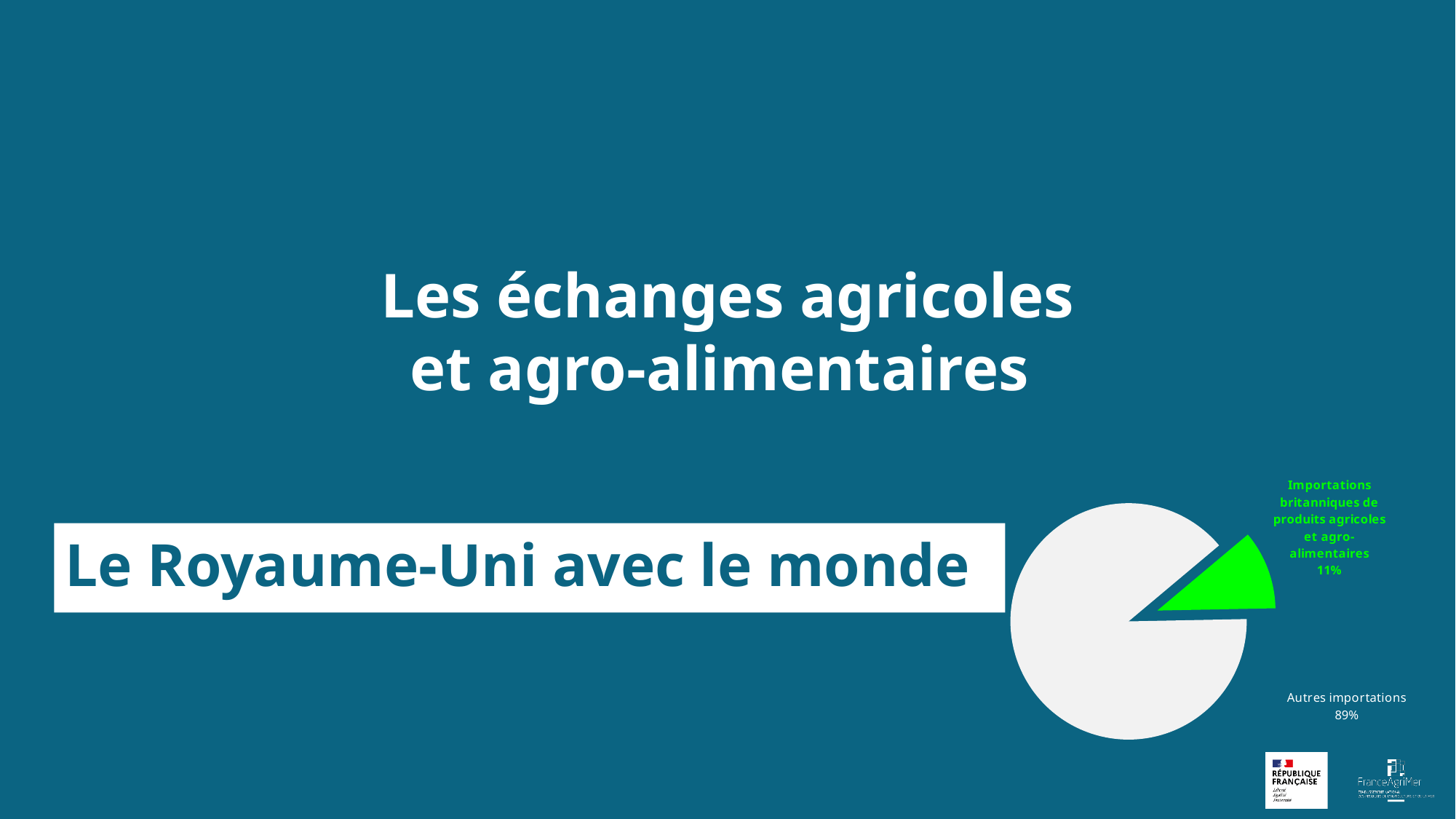
What colour is the slice for 'Importations britanniques de produits agricoles et agro-alimentaires'? green Which slice of the pie is the largest? Autres importations Which slice of the pie is the smallest? Importations britanniques de produits agricoles et agro-alimentaires How many slices does the pie chart have? 2 What is the difference in percentage points between 'Autres importations' and 'Importations britanniques de produits agricoles et agro-alimentaires'? 78 What colour is the slice for 'Autres importations'? light grey Which is larger: 'Autres importations' or 'Importations britanniques de produits agricoles et agro-alimentaires'? Autres importations What share of the pie is labelled 'Importations britanniques de produits agricoles et agro-alimentaires'? 11% What share of the pie is labelled 'Autres importations'? 89% What kind of chart is shown on the slide? pie chart